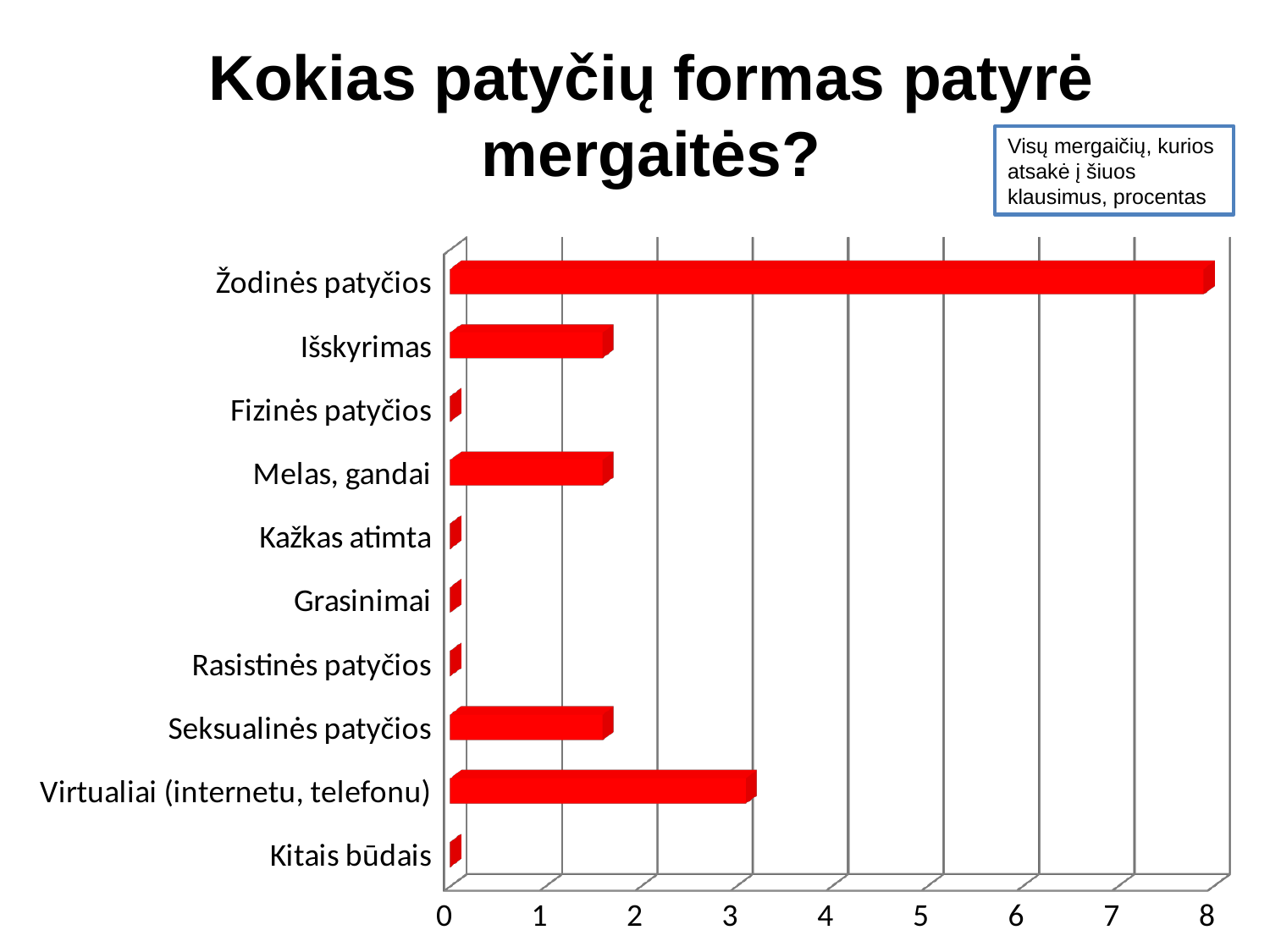
Is the value for Seksualinės patyčios greater or less than 1? greater What colour are the bars in the chart? red Which is larger, the value for Virtualiai (internetu, telefonu) or the value for Melas, gandai? Virtualiai (internetu, telefonu) What is the title of the slide containing the chart? Kokias patyčių formas patyrė mergaitės? Is the value for Išskyrimas greater or less than 2? less What kind of chart is shown on the slide? bar chart Is the value for Fizinės patyčios greater or less than 1? less Which is larger, the value for Žodinės patyčios or the value for Virtualiai (internetu, telefonu)? Žodinės patyčios How many categories of bullying forms are shown in the chart? 10 Which category has the highest value in the chart? Žodinės patyčios